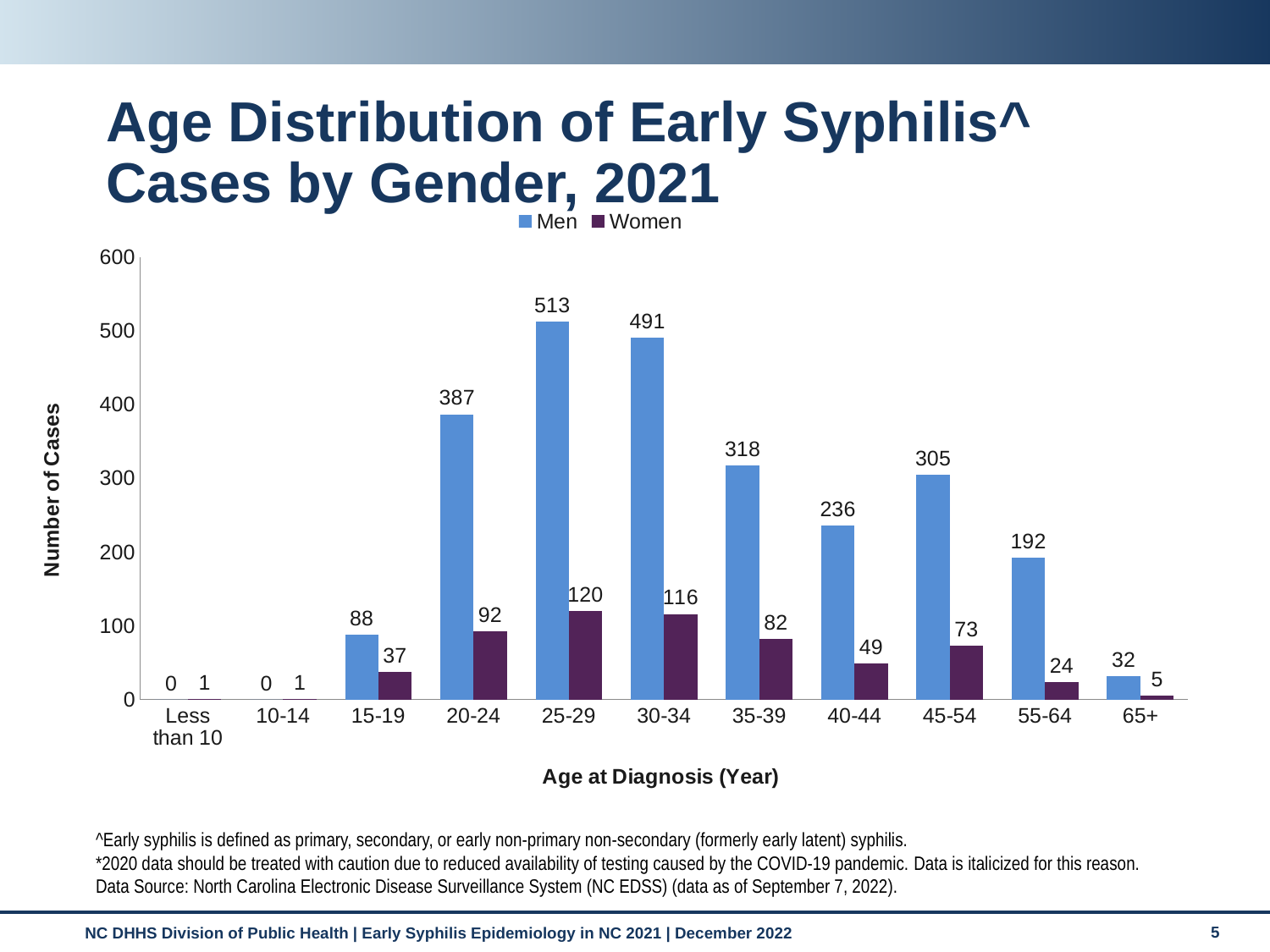
How many early syphilis cases were reported among women aged 20-24? 92 Which age group has the highest number of cases among men? 25-29 What kind of chart is shown on the slide? Bar chart How many age groups are shown on the x axis? 11 What is the label of the y axis? Number of Cases How many early syphilis cases were reported among men aged 25-29? 513 Which is larger: the number of cases for men aged 45-54 or men aged 40-44? Men aged 45-54 How many cases were reported among women aged 65+? 5 How many series does the legend list? 2 What is the difference between the number of cases for men and women in the 30-34 age group? 375 What is the total number of cases (men plus women) in the 35-39 age group? 400 Which age group has the highest number of cases among women? 25-29